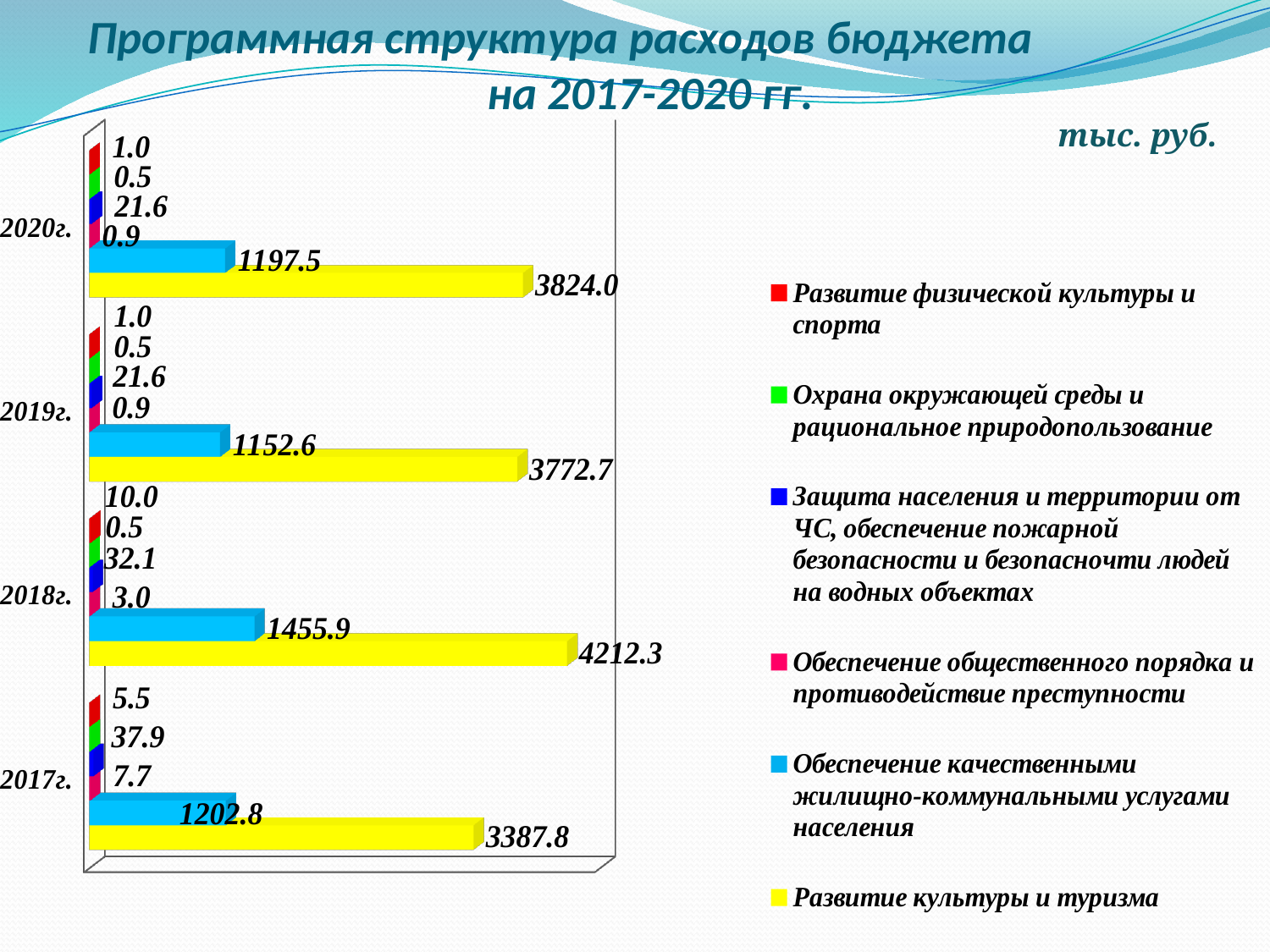
In 2018, how much larger is the value for «Развитие культуры и туризма» than the value for «Обеспечение качественными жилищно-коммунальными услугами населения»? 2756.4 What is the value for «Обеспечение качественными жилищно-коммунальными услугами населения» in 2019? 1152.6 What is the value for «Развитие культуры и туризма» in 2020? 3824.0 What kind of chart is shown on the slide? bar chart What is the value for «Обеспечение качественными жилищно-коммунальными услугами населения» in 2018? 1455.9 What is the difference between the «Развитие культуры и туризма» values for 2020 and 2019? 51.3 How many series does the legend list? 6 How many years (categories) are shown on the chart? 4 In which year is the value for «Развитие культуры и туризма» the lowest? 2017 Which year has the larger value for «Обеспечение качественными жилищно-коммунальными услугами населения»: 2017 or 2019? 2017 In what units are the chart values given, according to the slide? тыс. руб. In which year is the value for «Развитие культуры и туризма» the highest? 2018